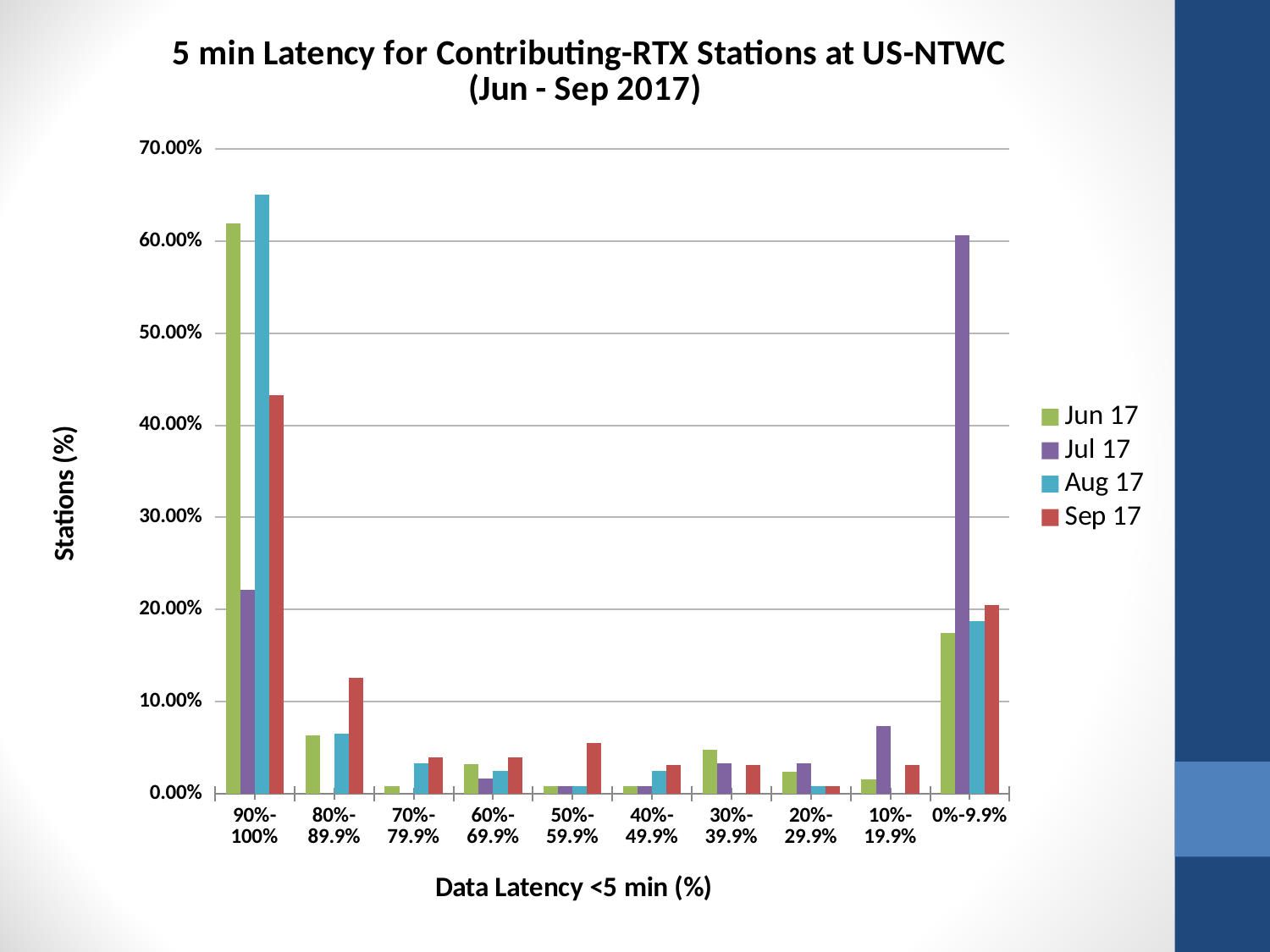
For the Aug 17 series, which category has the highest value? 90%-100% For the Jul 17 series, which category has the highest value? 0%-9.9% In the 0%-9.9% category, which is larger: Jul 17 or Aug 17? Jul 17 Is the Jul 17 value for the 90%-100% category greater or less than 30.00%? less What kind of chart is shown on the slide? bar chart How many series does the legend list? 4 Is the Aug 17 value for the 90%-100% category greater or less than 60.00%? greater Is the Sep 17 value for the 80%-89.9% category greater or less than 10.00%? greater Which series has the highest value in the 80%-89.9% category? Sep 17 How many latency categories are shown on the x axis? 10 What is the title of the y axis? Stations (%) In the 90%-100% category, which is larger: Jun 17 or Sep 17? Jun 17